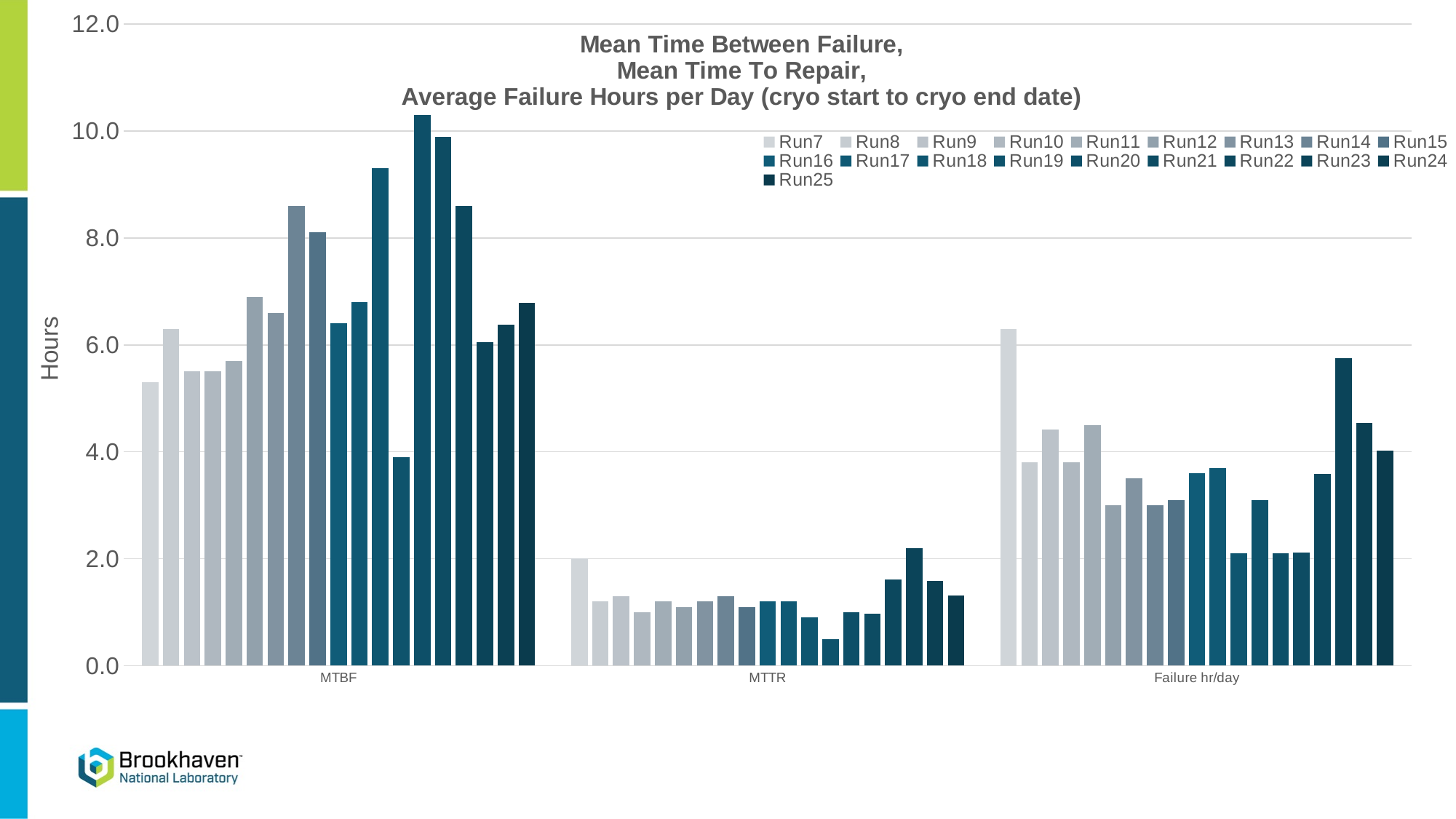
Is the leftmost (Run7) bar in the Failure hr/day group greater or less than 6.0? greater What is the first series listed in the legend? Run7 Which category has the lowest bars overall? MTTR Which category contains the tallest bar in the chart? MTBF Is the tallest bar in the MTTR group greater or less than 4.0? less Is the tallest bar in the MTBF group greater or less than 10.0? greater How many categories are shown on the x axis of the chart? 3 What is the label of the y axis? Hours How many series does the chart's legend list? 19 What kind of chart is shown on the slide? bar chart Is the tallest bar in the Failure hr/day group larger or smaller than the tallest bar in the MTBF group? smaller